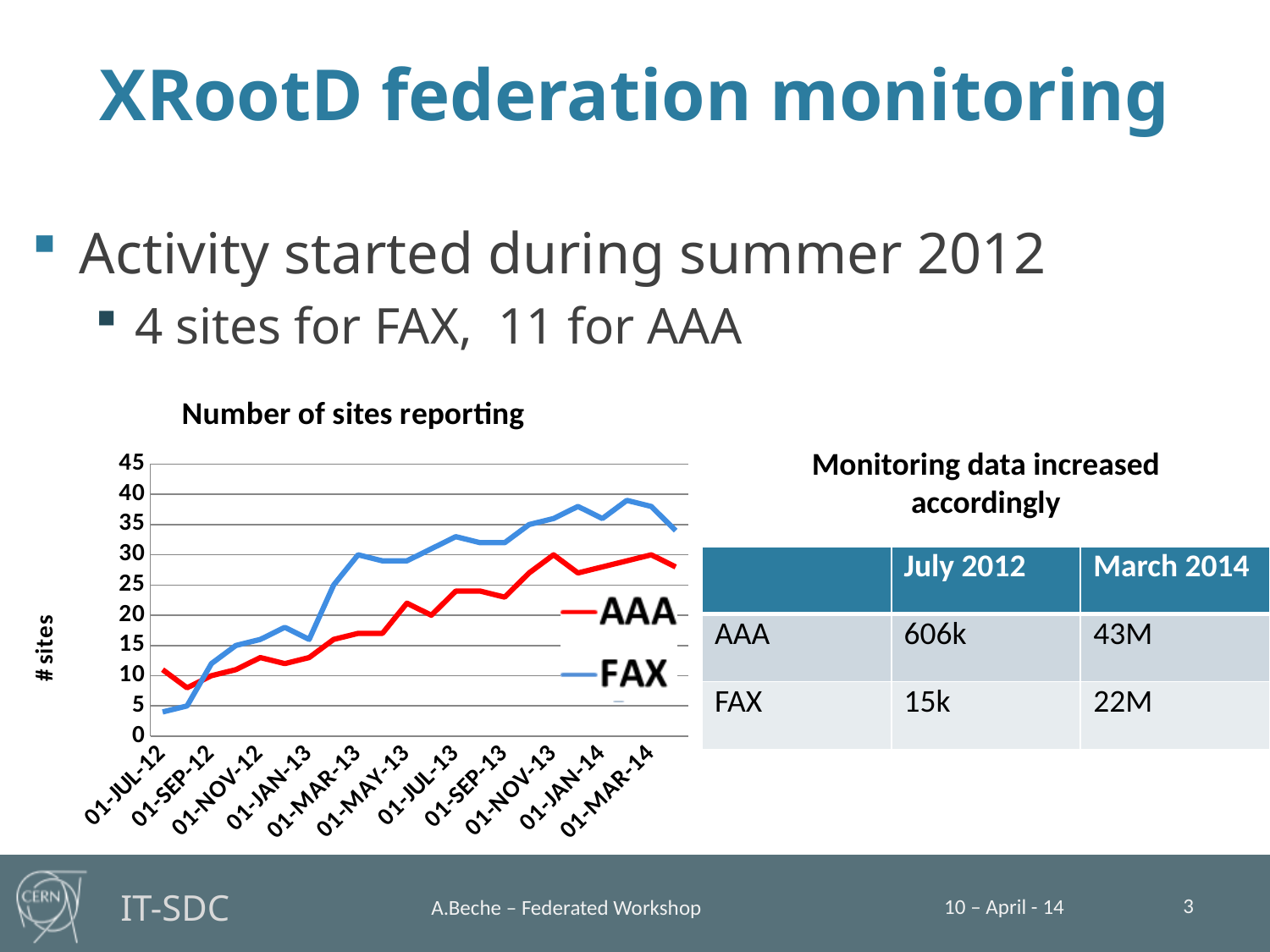
How many date labels are shown along the x axis of the 'Number of sites reporting' chart? 11 In the 'Number of sites reporting' chart, which series is higher at 01-JUL-12, AAA or FAX? AAA In the 'Number of sites reporting' chart, does the AAA series generally rise or fall over the period shown? rise In the 'Number of sites reporting' chart, is the value for AAA at 01-MAY-13 greater or less than 20? greater In the 'Number of sites reporting' chart, which series is higher at 01-MAR-14, AAA or FAX? FAX In the 'Number of sites reporting' chart, is the value for FAX at 01-MAR-14 greater or less than 30? greater What is the label on the vertical axis of the 'Number of sites reporting' chart? # sites How many series does the legend of the 'Number of sites reporting' chart list? 2 In the 'Number of sites reporting' chart, does the FAX series generally rise or fall from 01-JUL-12 to 01-MAR-14? rise What is the title of the chart on the slide? Number of sites reporting What kind of chart is 'Number of sites reporting'? line chart